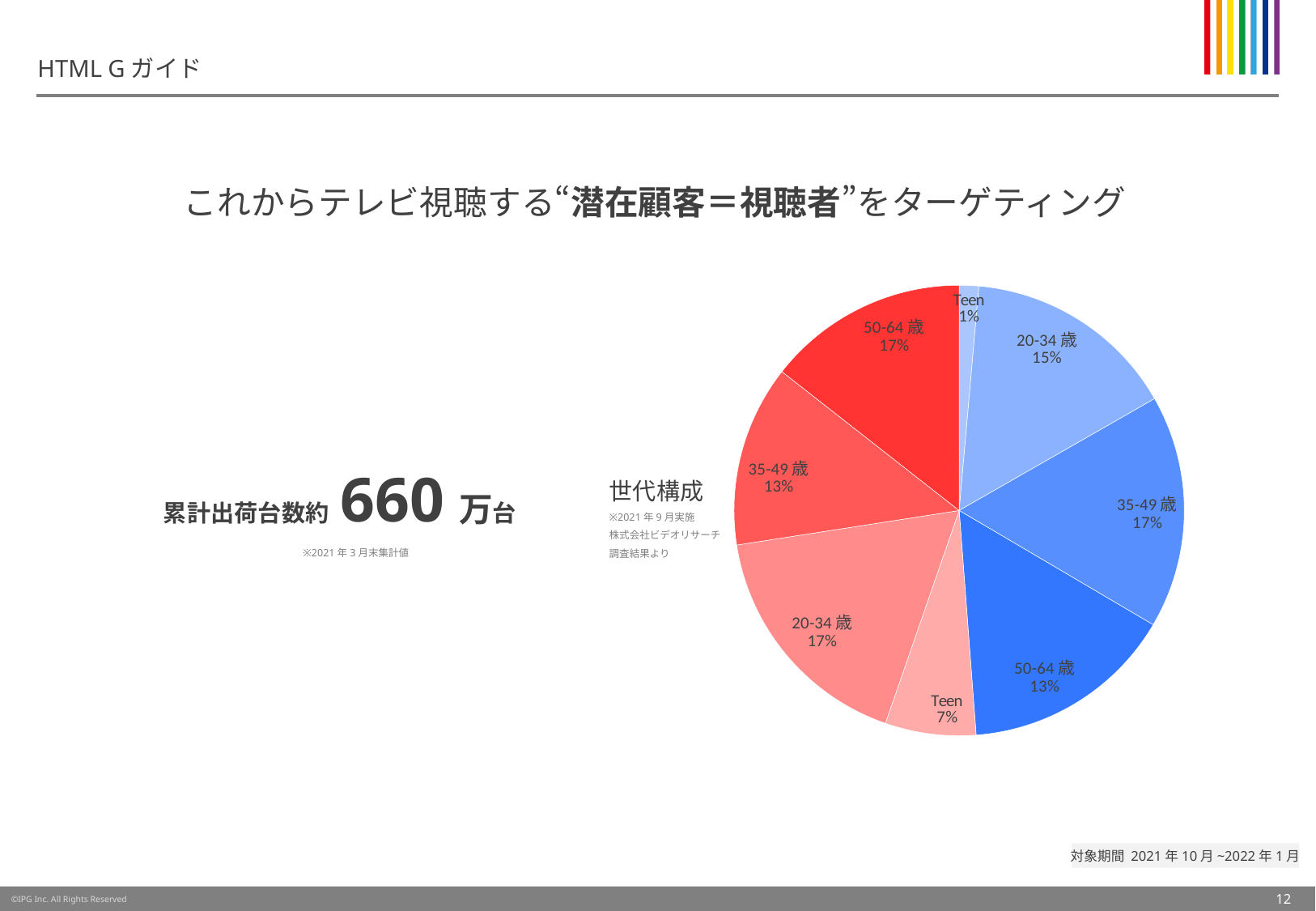
What is the difference in percentage points between the pink Teen slice (7%) and the blue Teen slice (1%)? 6 Which slice of the pie is the smallest? the blue Teen slice (1%) What share of the pie does the red 50-64 歳 slice represent? 17% What is the title of the pie chart? 世代構成 What kind of chart is shown on the slide? pie chart What percentage is shown for the pink Teen slice at the bottom of the pie? 7% What percentage is shown for the red 35-49 歳 slice on the left side of the pie? 13% What percentage is shown for the light blue Teen slice at the top of the pie? 1% How many slices does the pie chart have? 8 What percentage is shown for the blue 20-34 歳 slice? 15% What is the combined percentage of the four blue slices (Teen, 20-34 歳, 35-49 歳, 50-64 歳)? 46% Which is larger: the blue 20-34 歳 slice or the red 20-34 歳 slice? the red 20-34 歳 slice